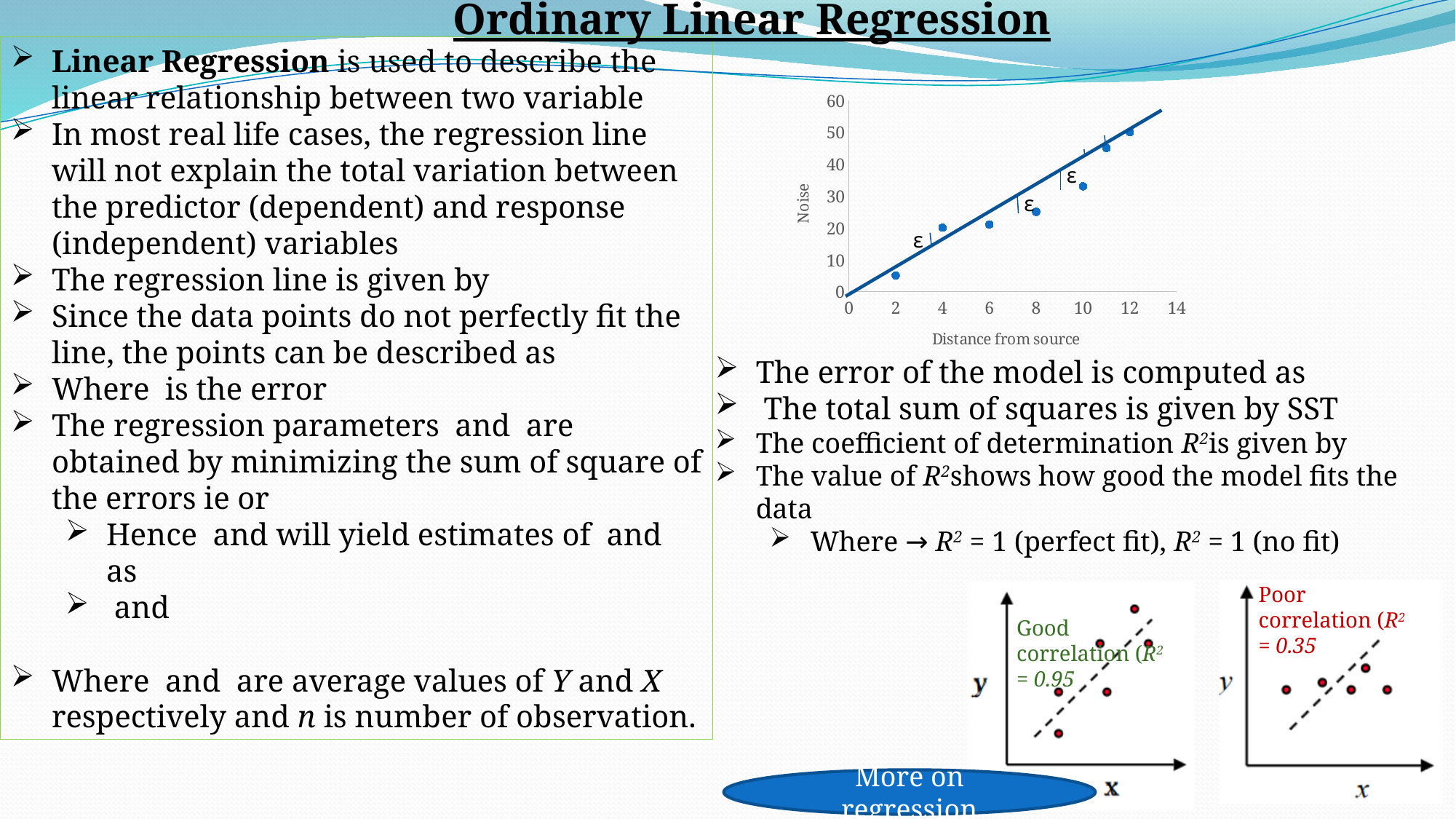
In the Noise vs Distance from source chart, which plotted point has the highest Noise value, the one at distance 2 or the one at distance 12? distance 12 How many data points are plotted in the Noise vs Distance from source chart? 7 In the Noise vs Distance from source chart, do the Noise values rise or fall as Distance from source increases? rise What is the label of the horizontal axis of the scatter chart? Distance from source In the Noise vs Distance from source chart, is the Noise value at distance 10 greater or less than 40? less What kind of chart is shown at the top right of the slide? scatter chart In the Noise vs Distance from source chart, is the Noise value at distance 12 greater or less than 40? greater In the Noise vs Distance from source chart, is the Noise value at distance 2 greater or less than 10? less What is the label of the vertical axis of the scatter chart? Noise